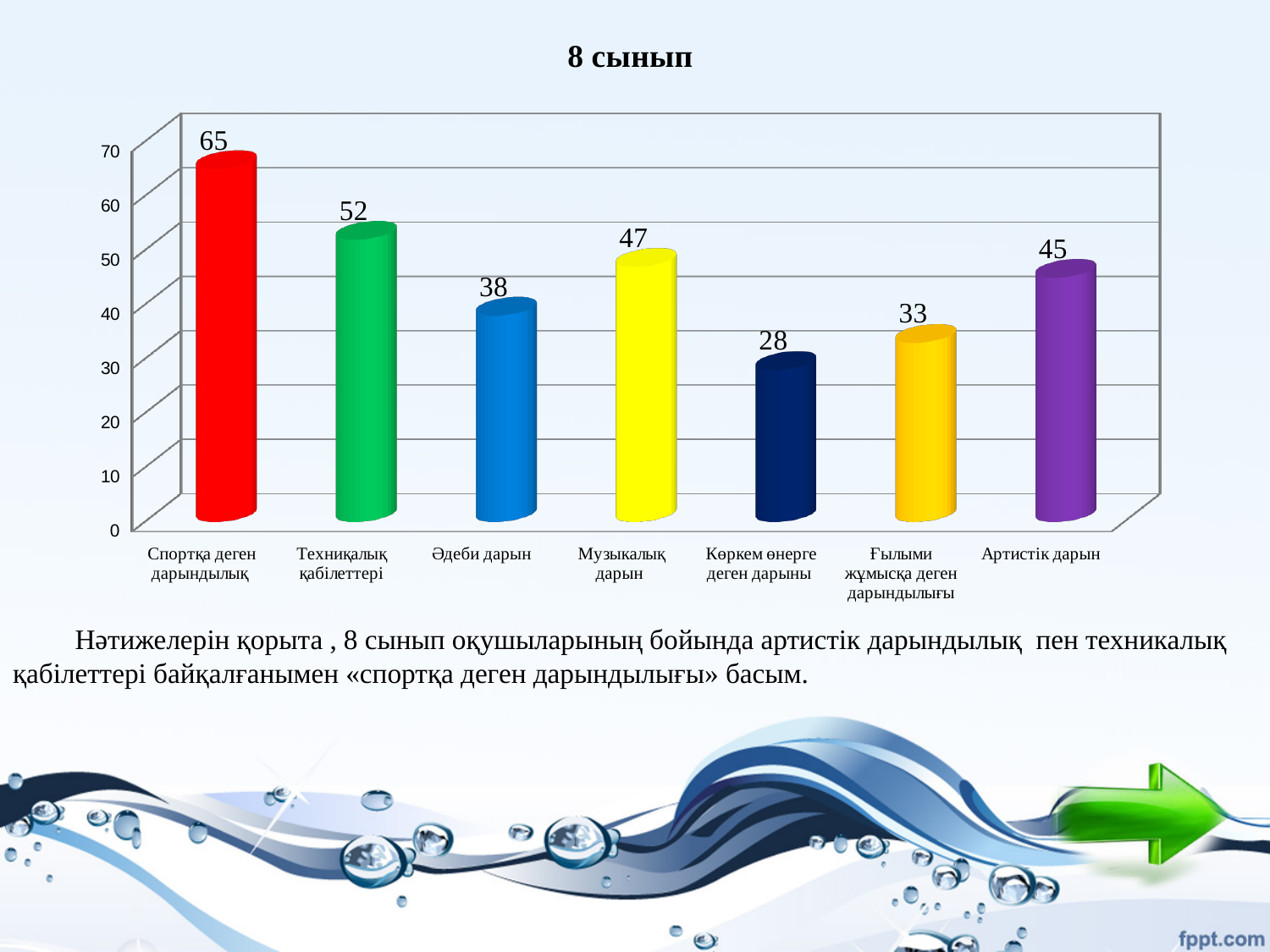
Which category has the highest value? Спортқа деген дарындылық What colour is the bar for Музыкалық дарын? yellow What is the value for Ғылыми жұмысқа деген дарындылығы? 33 What is the value for Спортқа деген дарындылық? 65 What is the value for Артистік дарын? 45 Which is larger, the value for Музыкалық дарын or the value for Артистік дарын? Музыкалық дарын How many categories are shown in the chart? 7 What kind of chart is shown on the slide? bar chart What is the difference between the values for Техникалық қабілеттері and Әдеби дарын? 14 Which category has the lowest value? Көркем өнерге деген дарыны What is the title of the chart? 8 сынып Is the value for Әдеби дарын greater or less than 40? less